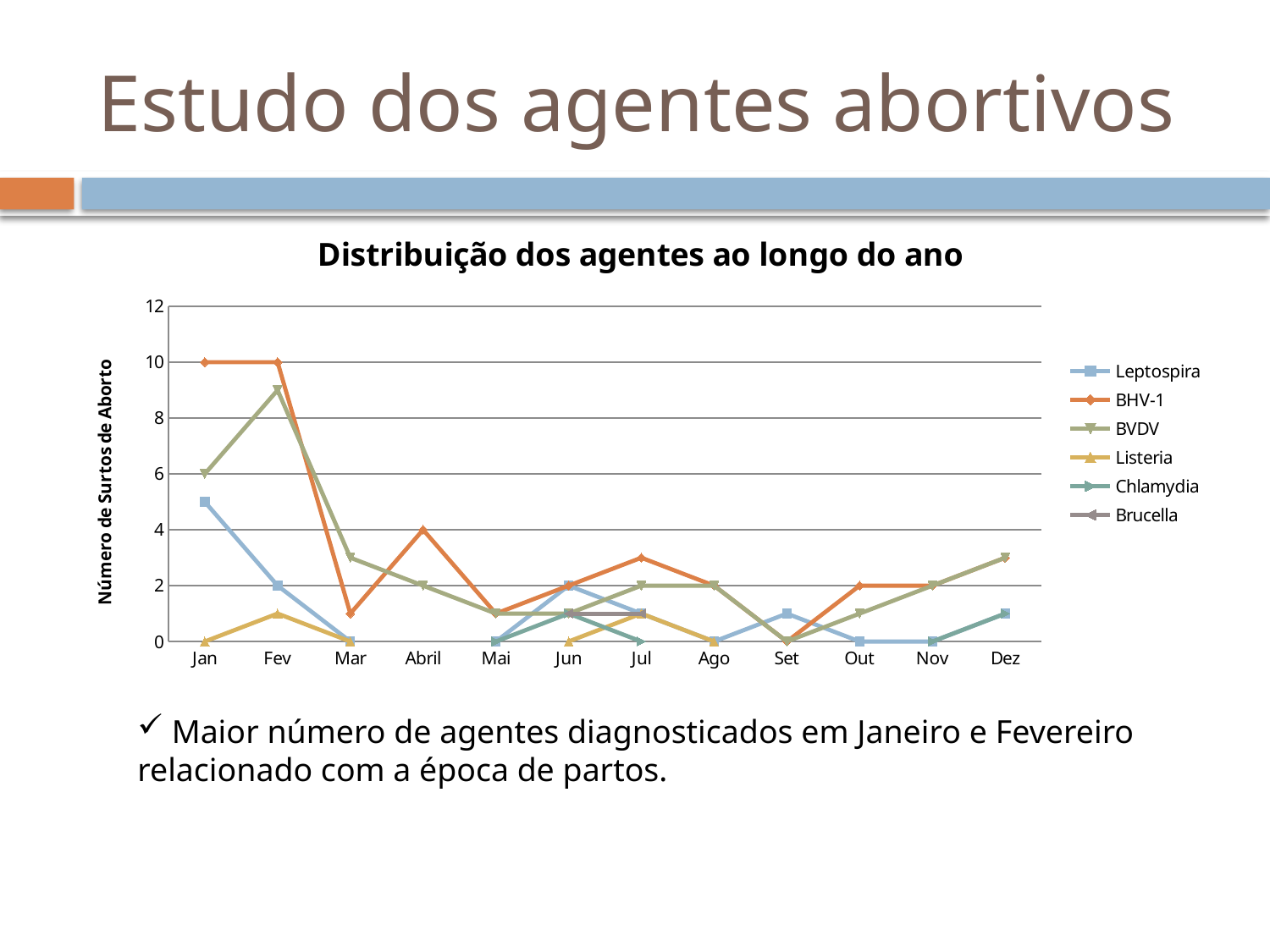
How many series does the legend list? 6 How many months are shown on the x axis? 12 What is the title of the chart? Distribuição dos agentes ao longo do ano Is the value for Leptospira in Jan greater or less than 4? greater What is the value for BHV-1 in Abril? 4 What is the value for BHV-1 in Jan? 10 Which series has the highest value in Jan? BHV-1 What is the difference between BHV-1 and BVDV in Jan? 4 Is the value for BVDV in Fev greater or less than 8? greater What type of chart is shown on the slide? line chart What is the value for BVDV in Jan? 6 What is the value for Listeria in Jan? 0